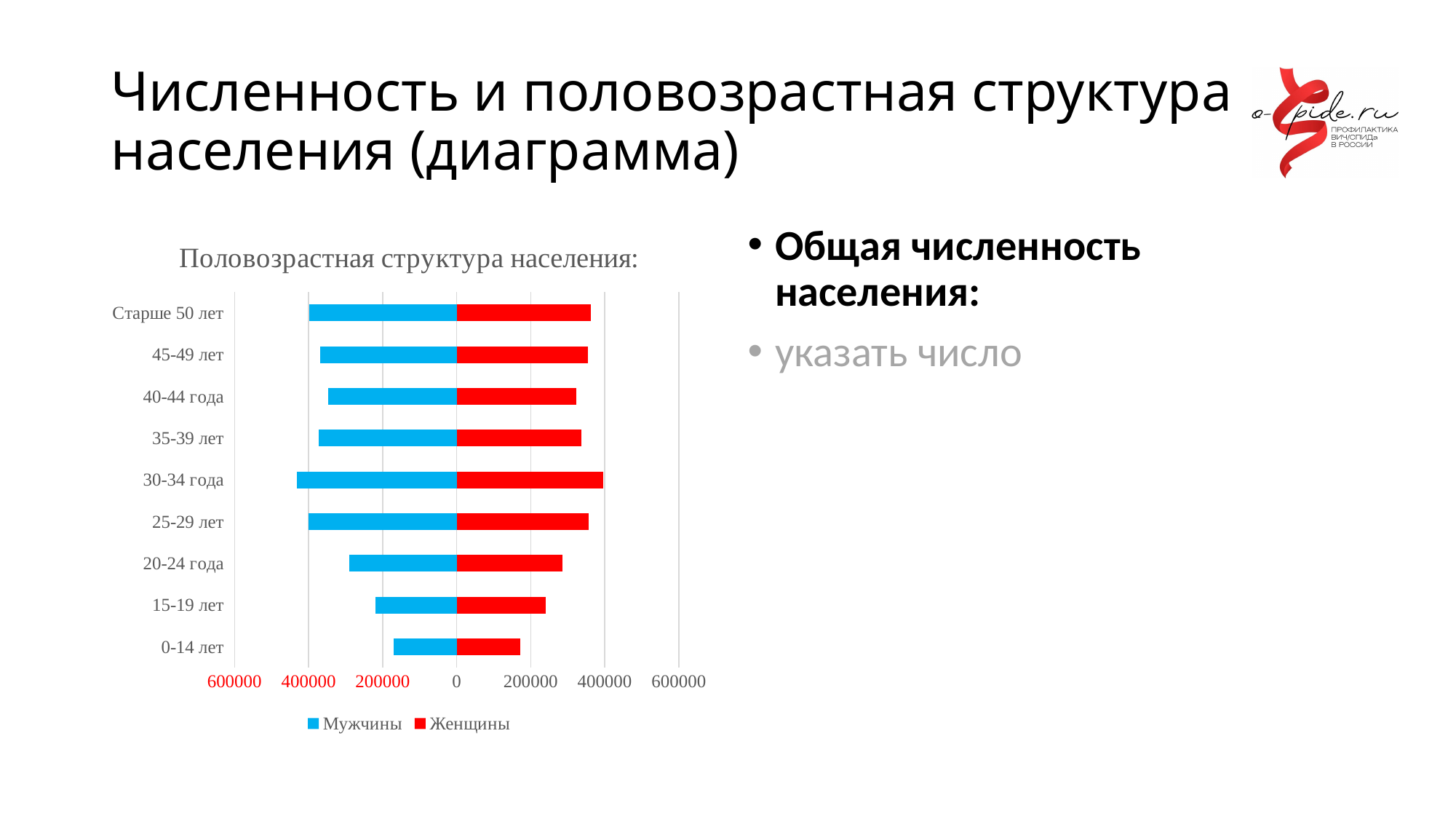
What kind of chart is shown on the slide? bar chart What is the title of the chart? Половозрастная структура населения: Which colour represents the series Мужчины in the chart? blue Is the value for Женщины in the 0-14 лет group greater or less than 200000? less Is the value for Мужчины in the 30-34 года group greater or less than 400000? greater Which is larger: the value for Женщины in the 30-34 года group or in the 20-24 года group? 30-34 года Which age group has the lowest value for Мужчины? 0-14 лет Which age group has the highest value for Мужчины? 30-34 года How many series does the chart legend list? 2 Which age group has the highest value for Женщины? 30-34 года How many age groups are shown on the chart? 9 Which age group has the lowest value for Женщины? 0-14 лет